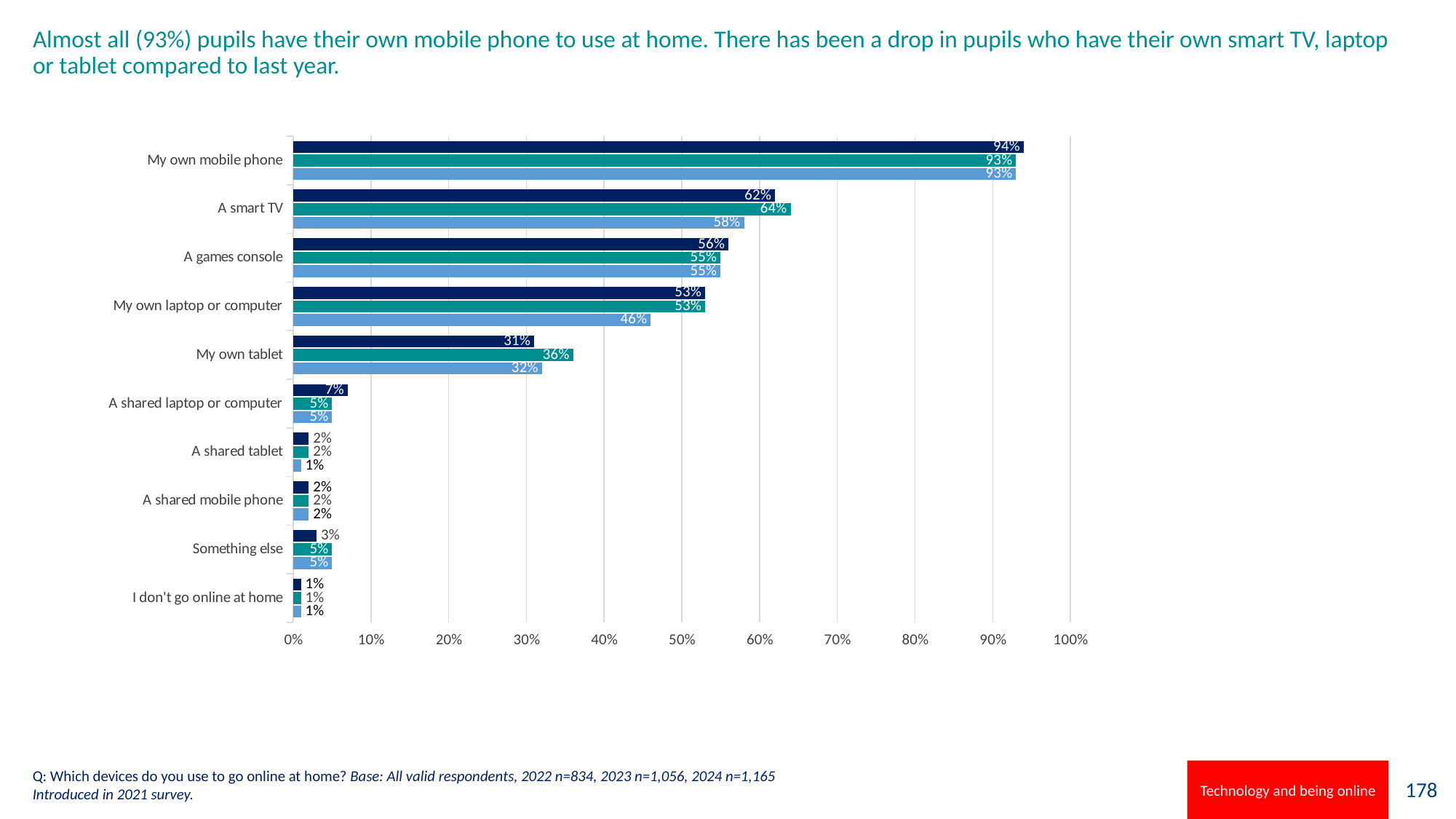
Which is larger for 'A shared laptop or computer': the dark navy (top) bar or the teal (middle) bar? the dark navy (top) bar What is the value of the dark navy (top) bar for 'My own mobile phone'? 94% Which device category has the highest values on the chart? My own mobile phone Which category has the lowest values on the chart? I don't go online at home What is the value of the teal (middle) bar for 'My own tablet'? 36% What kind of chart is shown on the slide? bar chart What is the value of the light blue (bottom) bar for 'A smart TV'? 58% What is the difference between the teal (middle) bar and the light blue (bottom) bar for 'A smart TV'? 6% Is the dark navy (top) bar for 'A games console' greater or less than 50%? greater What is the difference between the dark navy (top) bar and the teal (middle) bar for 'Something else'? 2% How many device categories are listed on the chart? 10 What is the value of the light blue (bottom) bar for 'My own laptop or computer'? 46%